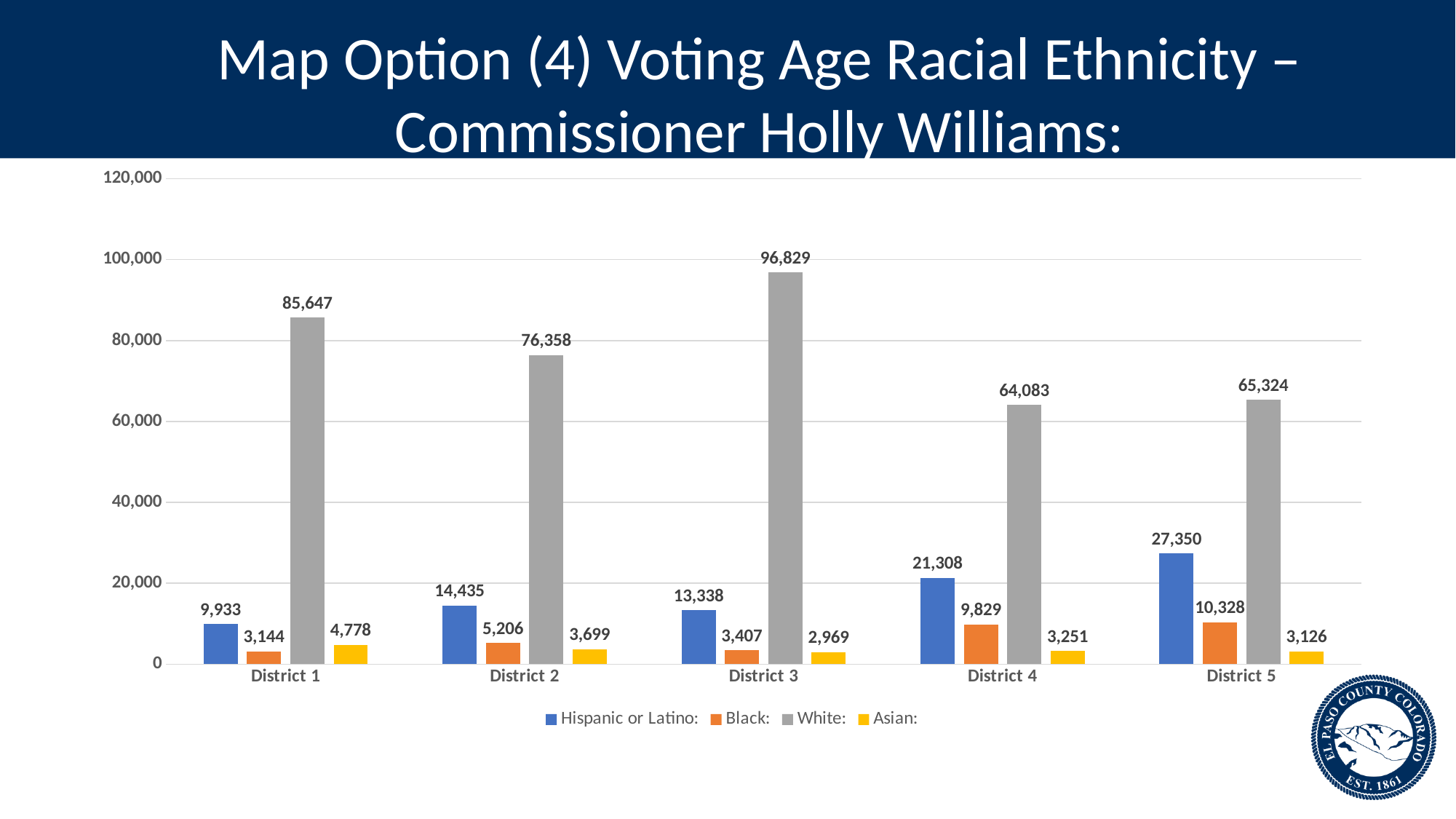
What is the difference between the White values for District 1 and District 2? 9,289 Is the White value for District 4 greater or less than 60,000? greater Which is larger, the Black value for District 4 or for District 5? District 5 What is the value for Hispanic or Latino in District 5? 27,350 What is the value for Asian in District 1? 4,778 What is the value for White in District 3? 96,829 Which district has the lowest Hispanic or Latino value? District 1 How many districts are shown on the x axis? 5 Which district has the highest White value? District 3 How many series does the legend list? 4 What kind of chart is shown on the slide? bar chart What is the difference between the Hispanic or Latino values for District 5 and District 1? 17,417